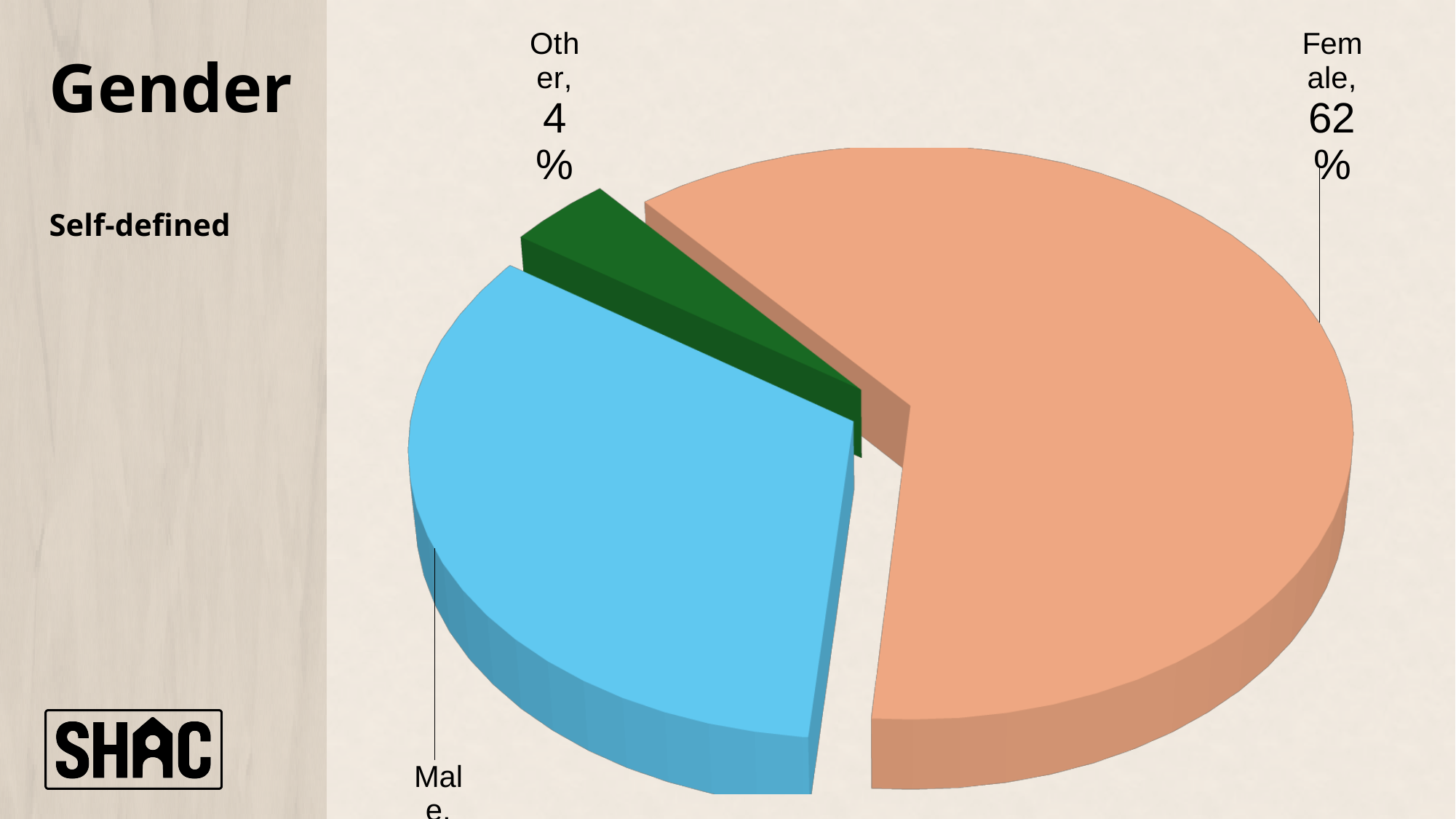
What is the difference in percentage points between the Female and Other slices? 58% Which category has the smallest slice of the pie? Other What colour is the Male slice? blue What is the title of the slide containing the pie chart? Gender What kind of chart is shown on the slide? pie chart Which slice is larger, Female or Male? Female How many slices does the pie chart have? 3 Which slice is larger, Male or Other? Male What percentage of the pie is Female? 62% What share of the pie does the Female slice represent? 62% Which category has the largest slice of the pie? Female What percentage of the pie is Other? 4%